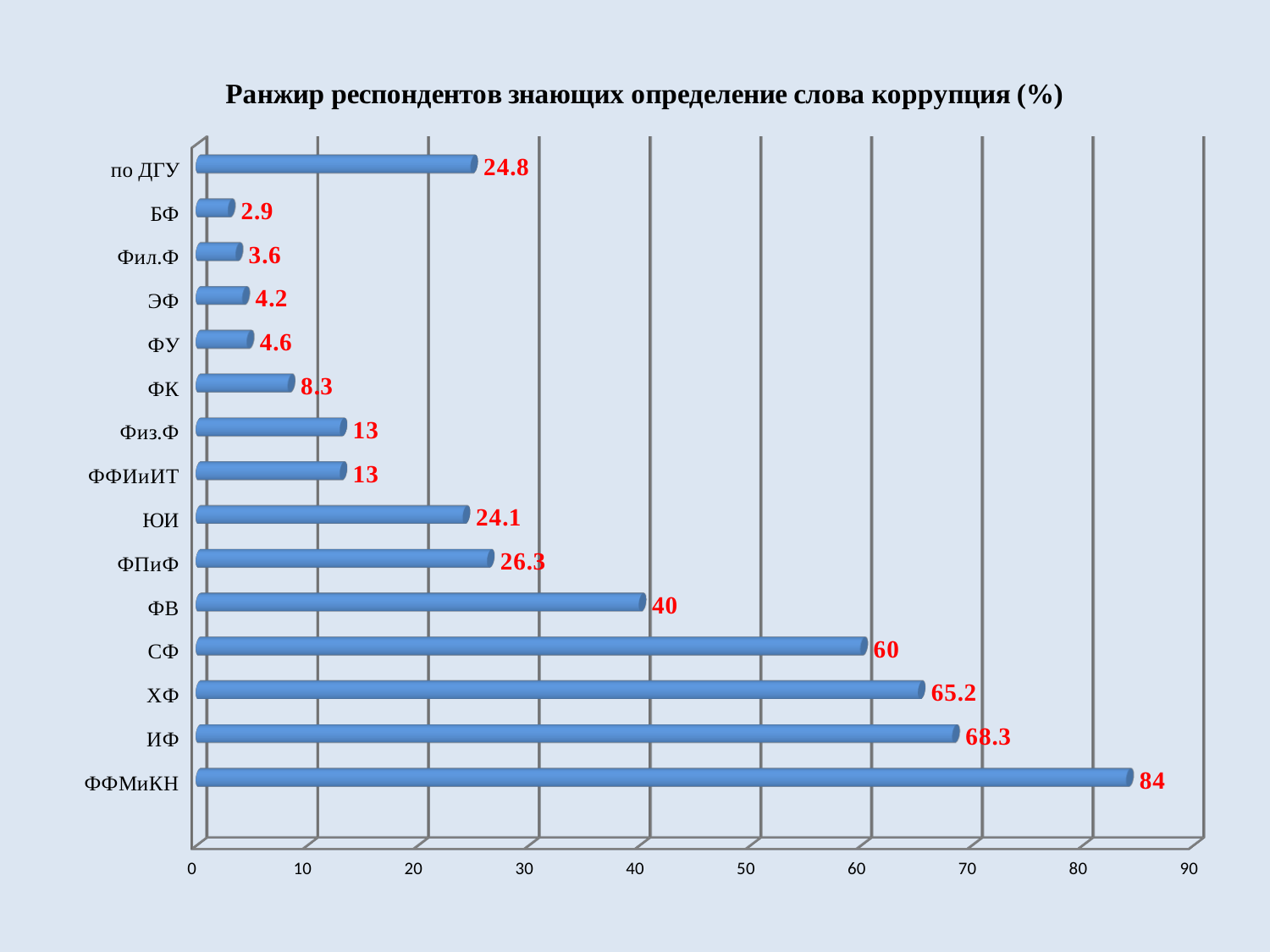
What is the difference between the values for ФФМиКН and по ДГУ? 59.2 Which category has the highest value? ФФМиКН How many categories are shown on the chart? 15 What is the value for ХФ? 65.2 What is the value for по ДГУ? 24.8 What is the title of the chart? Ранжир респондентов знающих определение слова коррупция (%) What is the difference between the values for ИФ and ХФ? 3.1 Which category has the lowest value? БФ Which is larger, the value for СФ or the value for ФВ? СФ What kind of chart is shown on the slide? bar chart What is the value for ФФМиКН? 84 Is the value for ФПиФ greater or less than 30? less